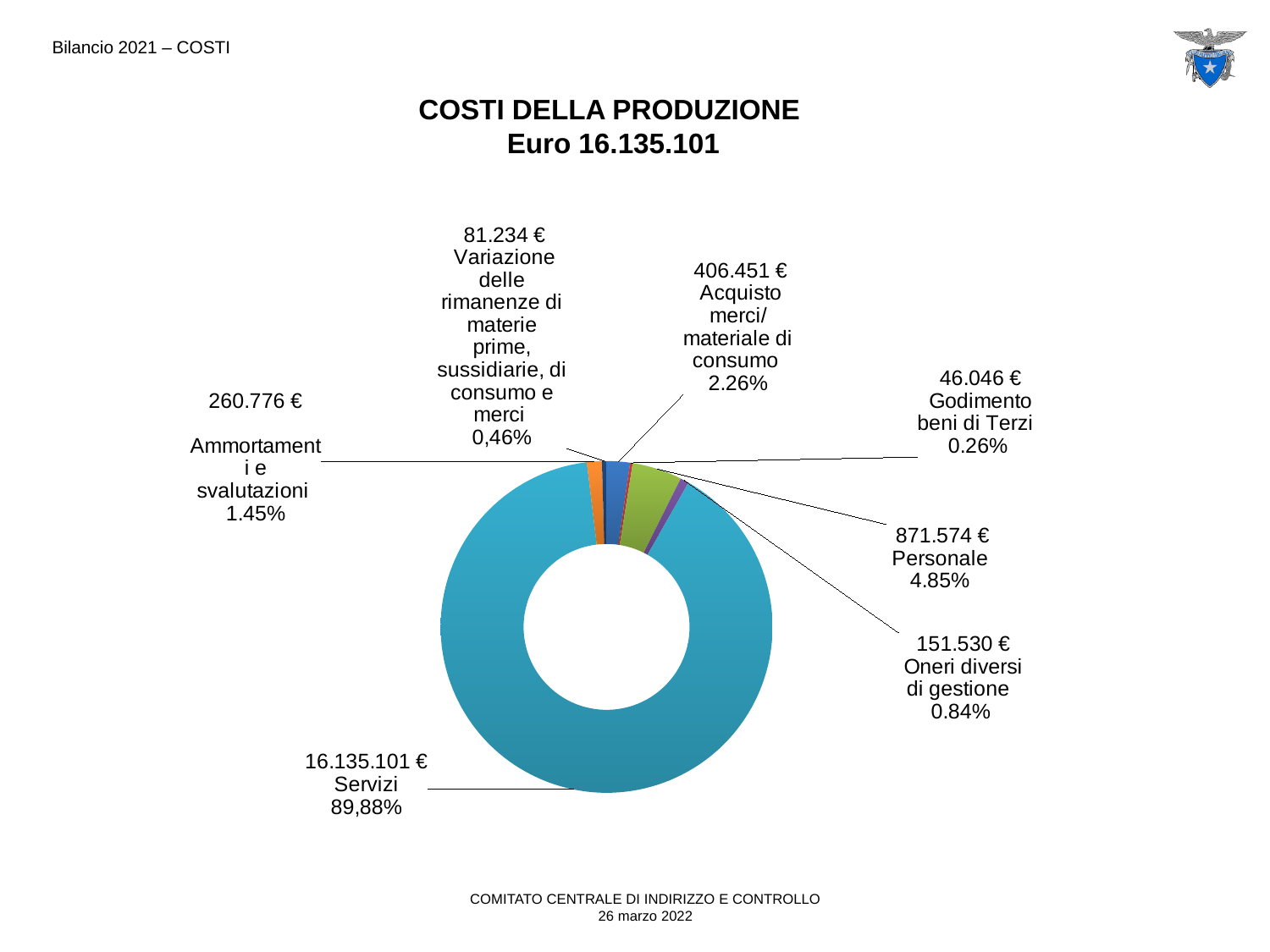
What percentage share is shown for Servizi? 89,88% How many categories (slices) does the chart show? 7 What is the difference between the values for Personale and Acquisto merci/materiale di consumo? 465.123 € What percentage share is shown for Acquisto merci/materiale di consumo? 2.26% What kind of chart is shown on the slide? Doughnut (pie) chart What is the value shown for Oneri diversi di gestione? 151.530 € Which category has the smallest slice? Godimento beni di Terzi Which category has the largest slice? Servizi Which is larger, Ammortamenti e svalutazioni or Oneri diversi di gestione? Ammortamenti e svalutazioni What is the value shown for Godimento beni di Terzi? 46.046 € What is the title of the chart? COSTI DELLA PRODUZIONE Euro 16.135.101 What is the value shown for Personale? 871.574 €